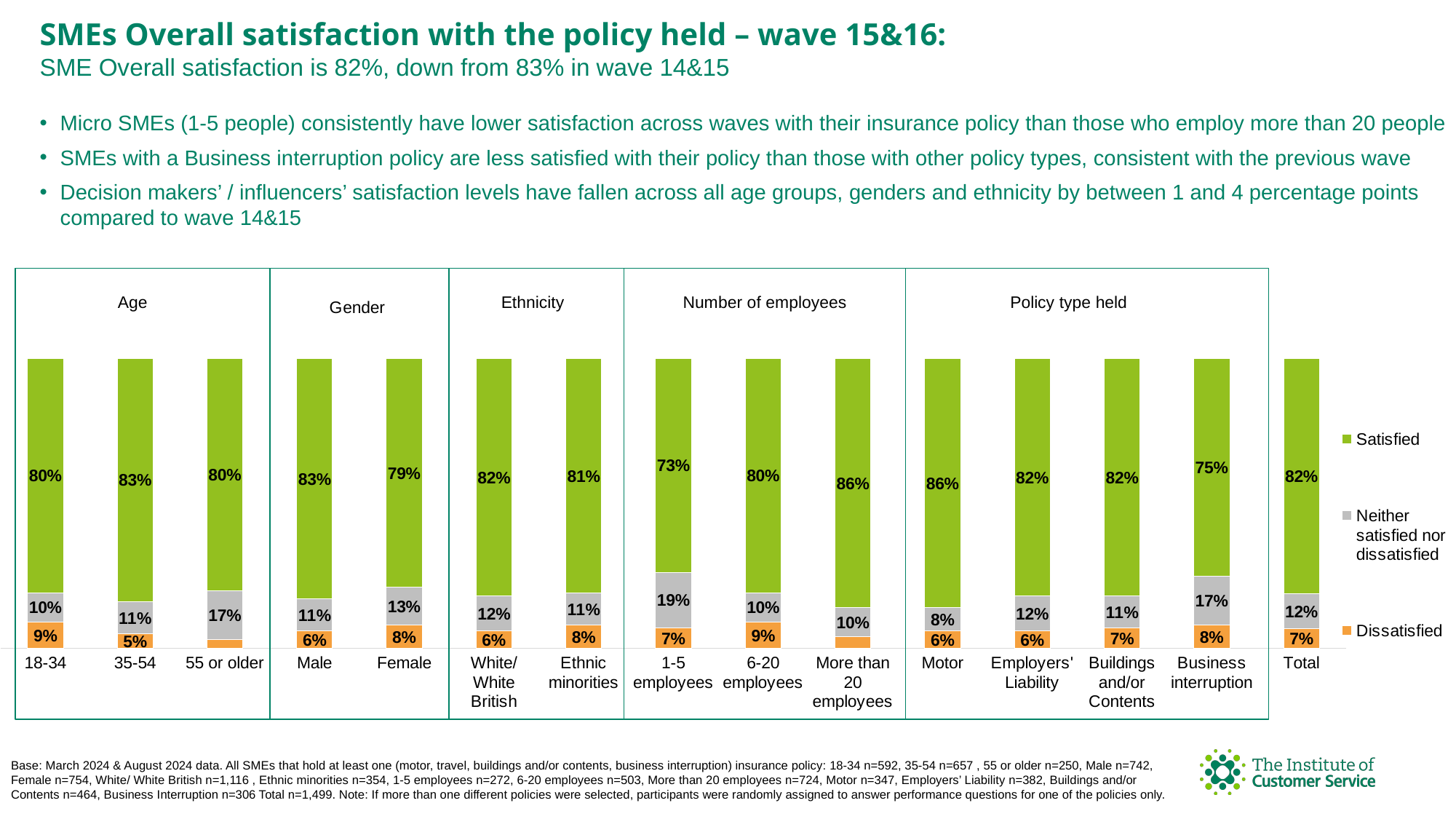
How many series does the legend list? 3 Which has a higher Satisfied percentage, 6-20 employees or More than 20 employees? More than 20 employees What is the difference in Neither satisfied nor dissatisfied percentage between Business interruption and Motor? 9 percentage points What is the Satisfied percentage for the Total bar? 82% What is the Neither satisfied nor dissatisfied percentage for SMEs with 1-5 employees? 19% How many bars are shown in the chart? 15 What type of chart is shown on the slide? Stacked bar chart What percentage of SMEs with a Business interruption policy are satisfied? 75% What is the difference in Satisfied percentage between Male and Female? 4 percentage points Which policy type held has the highest Satisfied percentage? Motor Which category has the lowest Satisfied percentage? 1-5 employees What is the Dissatisfied percentage for the 35-54 age group? 5%